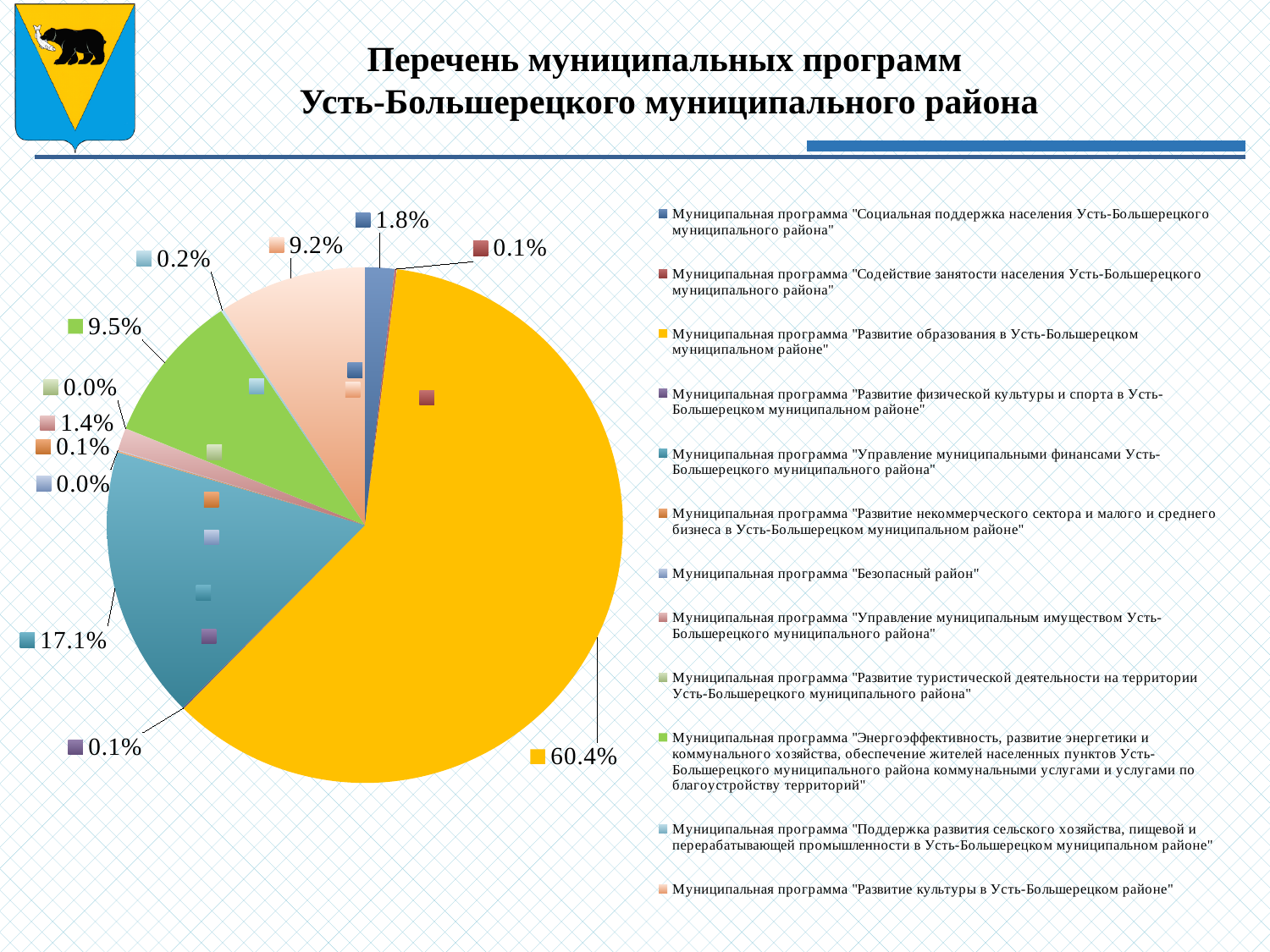
How many entries does the legend list? 12 What is the difference between the shares of "Развитие образования" (60.4%) and "Управление муниципальными финансами" (17.1%)? 43.3% What kind of chart is shown on the slide? pie chart What share of the pie does the program "Управление муниципальными финансами Усть-Большерецкого муниципального района" have? 17.1% Which is larger: the share for "Энергоэффективность, развитие энергетики и коммунального хозяйства..." or the share for "Развитие культуры в Усть-Большерецком районе"? Энергоэффективность, развитие энергетики и коммунального хозяйства (9.5%) What share is shown for the program "Управление муниципальным имуществом Усть-Большерецкого муниципального района"? 1.4% Which program has the largest slice of the pie? Муниципальная программа "Развитие образования в Усть-Большерецком муниципальном районе" What share is shown for the program "Развитие культуры в Усть-Большерецком районе"? 9.2% What share of the pie does the program "Развитие образования в Усть-Большерецком муниципальном районе" have? 60.4% What share is shown for the program "Поддержка развития сельского хозяйства, пищевой и перерабатывающей промышленности в Усть-Большерецком районе"? 0.2% What share is shown for the program "Социальная поддержка населения Усть-Большерецкого муниципального района"? 1.8% What colour is the slice for the program "Развитие образования в Усть-Большерецком муниципальном районе"? yellow